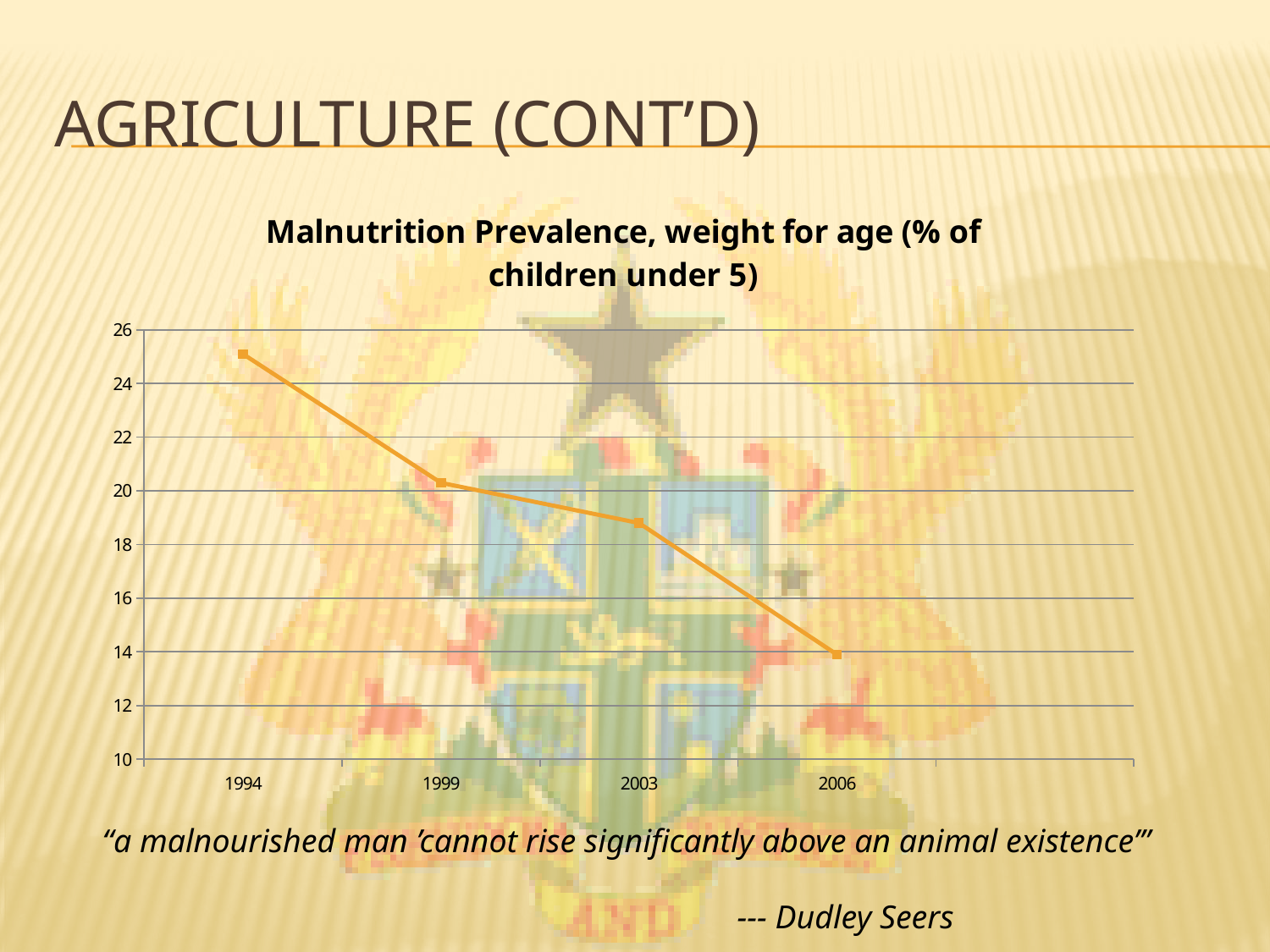
Is the value for 2003 greater or less than 20? less Which year has the larger value, 1994 or 2003? 1994 Which year has the larger value, 1999 or 2006? 1999 How many years are plotted on the x axis of the chart? 4 Is the value for 2006 greater or less than 16? less What kind of chart is shown on the slide? line chart Which year has the highest malnutrition prevalence in the chart? 1994 Which year has the lowest malnutrition prevalence in the chart? 2006 Do the values in the chart rise or fall from 1994 to 2006? fall What is the title of the chart? Malnutrition Prevalence, weight for age (% of children under 5) Is the value for 1994 greater or less than 24? greater